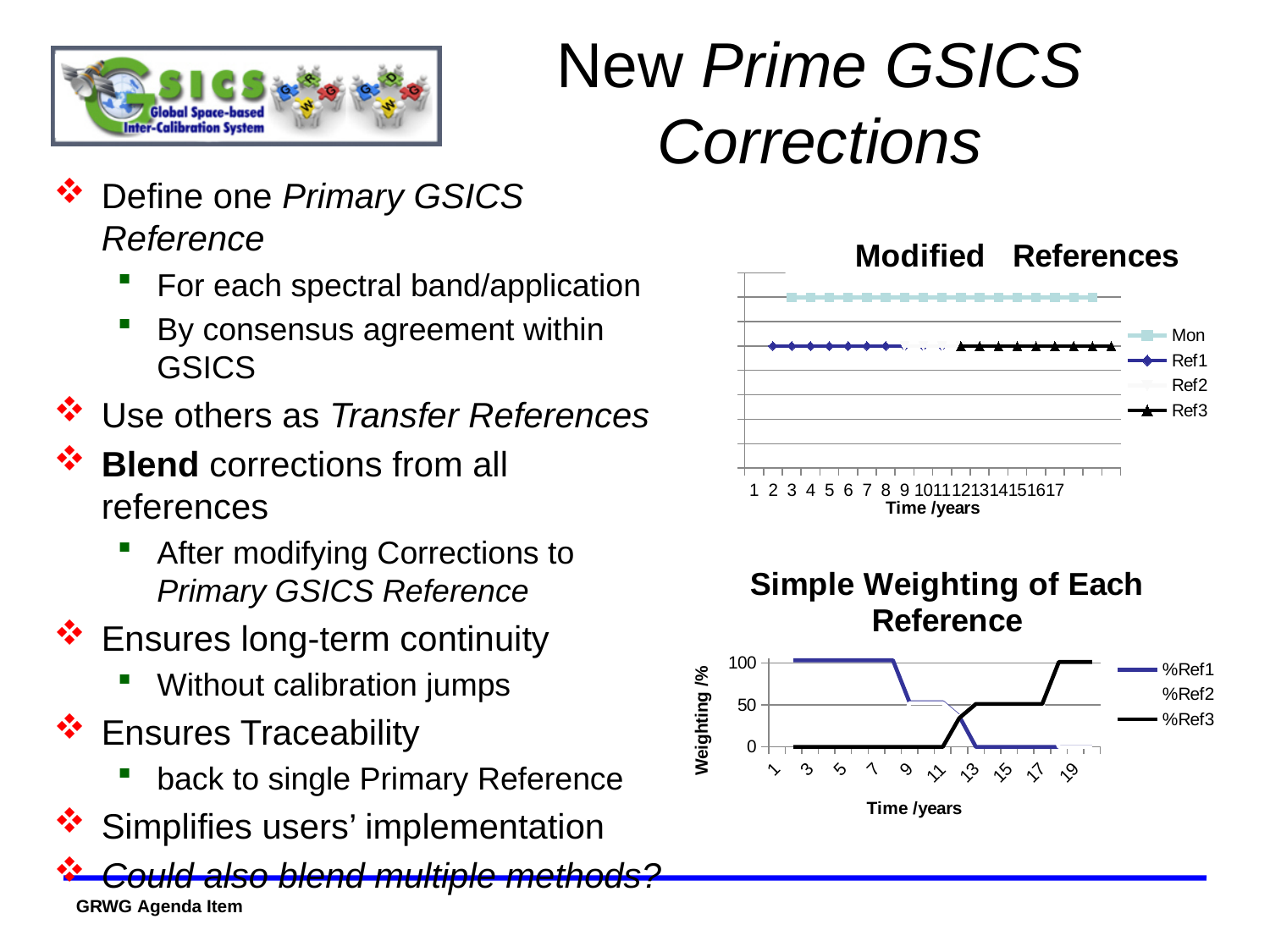
In the "Simple Weighting of Each Reference" chart, is the %Ref3 weighting at year 5 greater or less than 50? less In the "Simple Weighting of Each Reference" chart, does the %Ref3 weighting rise or fall as time increases? rise In the "Simple Weighting of Each Reference" chart, does the %Ref1 weighting rise or fall as time increases? fall How many series does the legend of the "Modified References" chart list? 4 What is the y-axis title of the "Simple Weighting of Each Reference" chart? Weighting /% What kind of chart is the "Simple Weighting of Each Reference" chart? line chart In the "Simple Weighting of Each Reference" chart, is the %Ref1 weighting at year 17 greater or less than 50? less How many series does the legend of the "Simple Weighting of Each Reference" chart list? 3 In the "Simple Weighting of Each Reference" chart, which series has the larger weighting at year 5, %Ref1 or %Ref3? %Ref1 What are the legend entries of the "Modified References" chart? Mon, Ref1, Ref2, Ref3